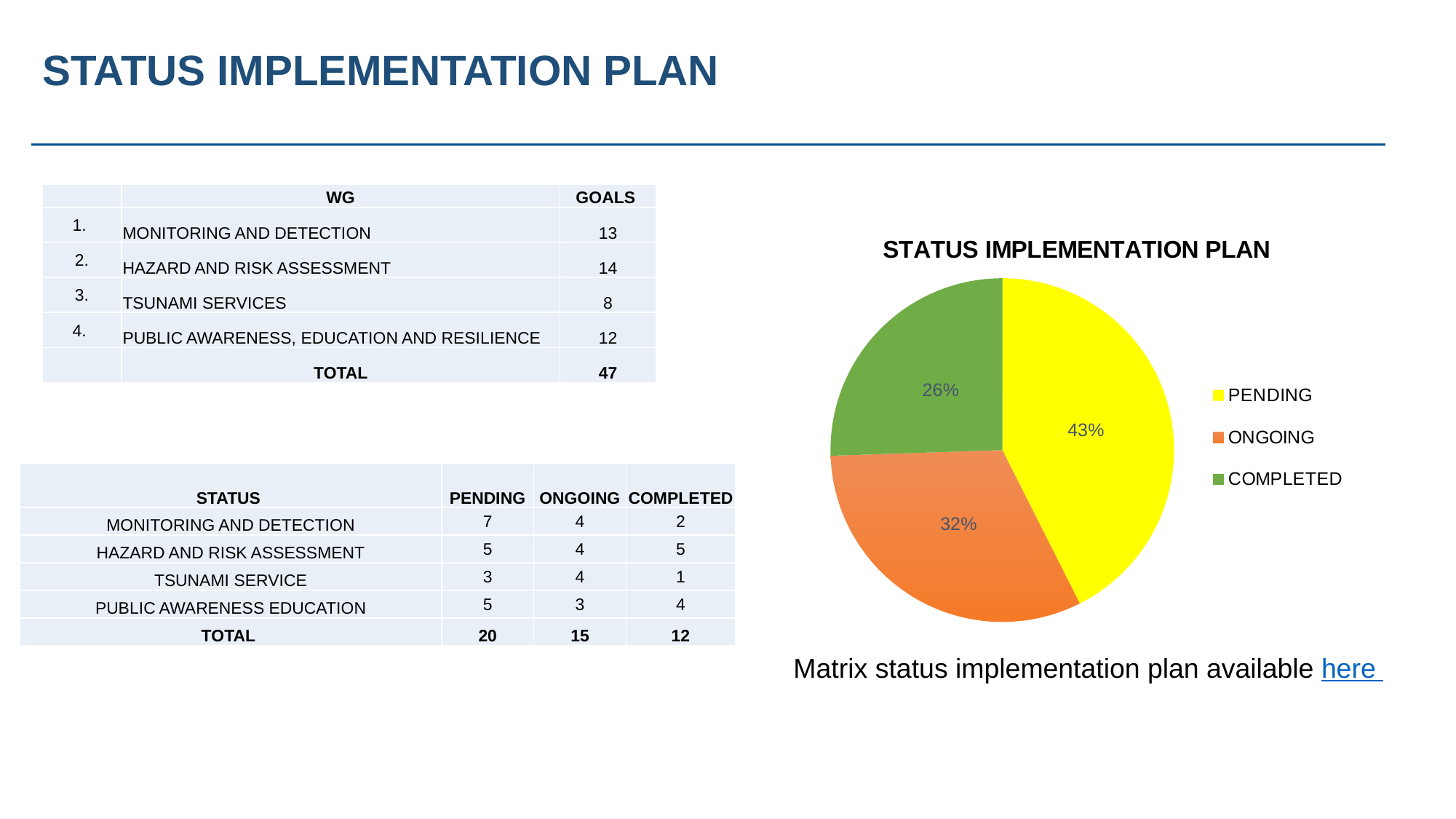
Is the share for ONGOING greater or less than 25%? greater What colour is the PENDING slice? yellow What share of the pie does PENDING represent? 43% What share of the pie does COMPLETED represent? 26% What is the difference in percentage points between the PENDING and COMPLETED slices? 17% Which is larger, the ONGOING slice or the COMPLETED slice? ONGOING What is the title of the chart? STATUS IMPLEMENTATION PLAN What share of the pie does ONGOING represent? 32% What type of chart is shown on the slide? pie chart How many categories does the legend list? 3 Which category has the smallest slice of the pie? COMPLETED Which category has the largest slice of the pie? PENDING